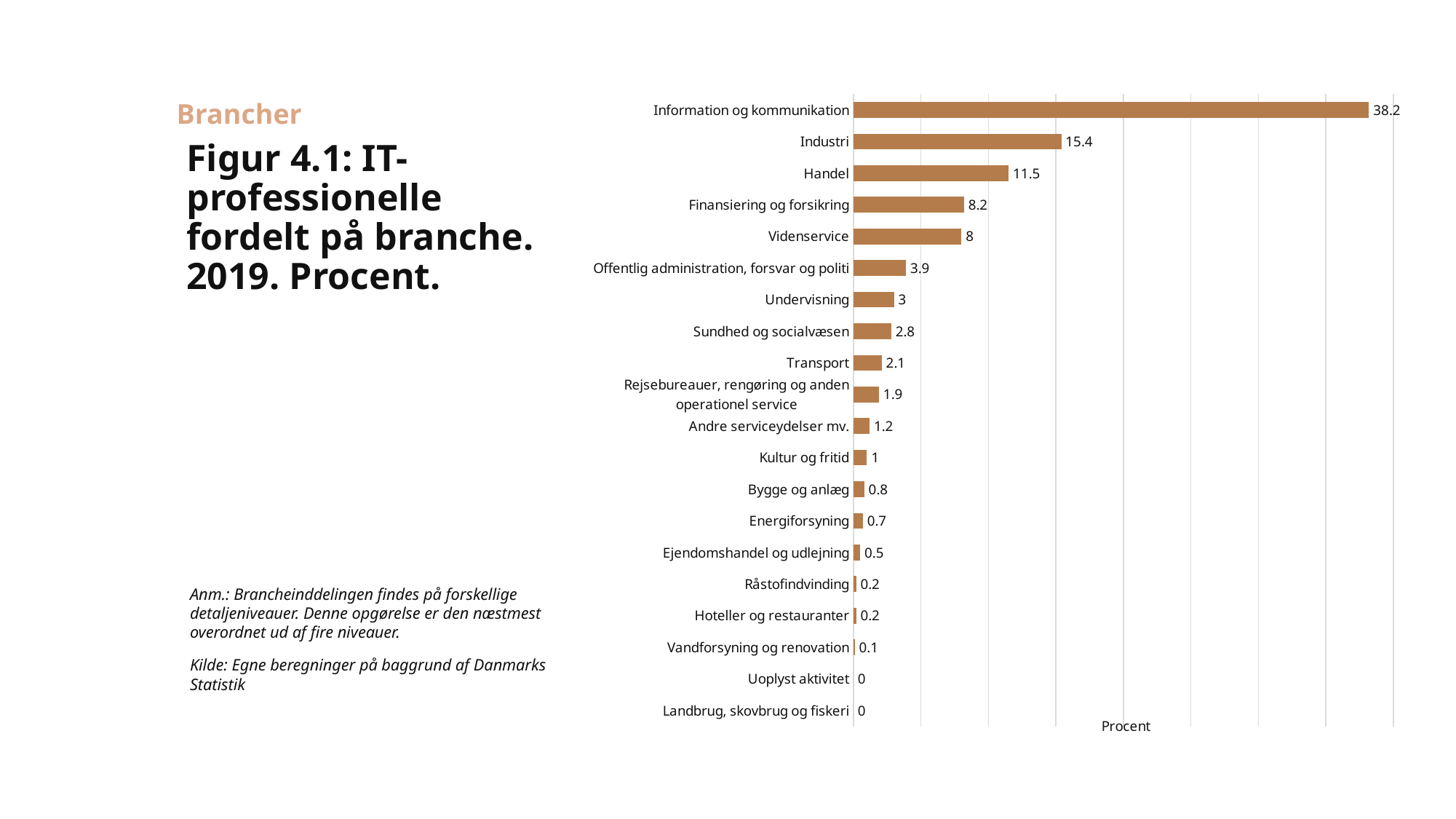
What is the value for Vandforsyning og renovation? 0.1 What is the difference between the values for Handel and Finansiering og forsikring? 3.3 What is the title of the figure on the slide? Figur 4.1: IT-professionelle fordelt på branche. 2019. Procent. What kind of chart is shown on the slide? Bar chart What is the difference between the values for Information og kommunikation and Industri? 22.8 What is the value for Industri? 15.4 What is the value for Sundhed og socialvæsen? 2.8 Which category has the highest value? Information og kommunikation Which is larger, the value for Videnservice or the value for Offentlig administration, forsvar og politi? Videnservice What is the value for Finansiering og forsikring? 8.2 How many categories are shown in the chart? 20 What is the value for Information og kommunikation? 38.2